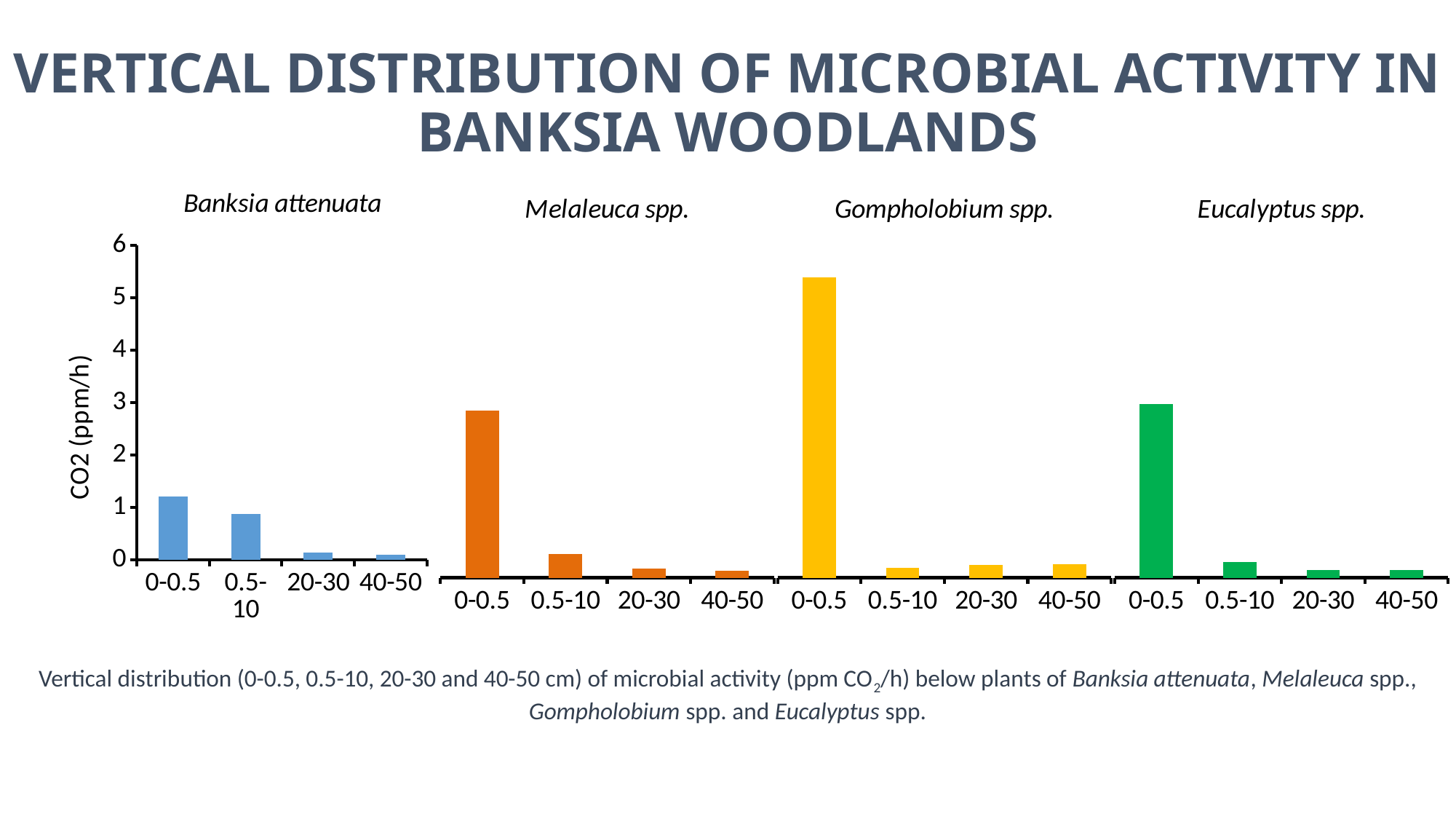
How many charts are shown on the slide? 4 In the Gompholobium spp. chart, which depth category has the highest value? 0-0.5 In the Banksia attenuata chart, which is larger, the value for 0-0.5 or for 0.5-10? 0-0.5 In the Gompholobium spp. chart, is the value for 0-0.5 greater or less than 4? greater In the Banksia attenuata chart, is the value for 0-0.5 greater or less than 1? greater Which is larger, the 0-0.5 value in the Gompholobium spp. chart or the 0-0.5 value in the Melaleuca spp. chart? Gompholobium spp. What is the label on the vertical axis of the Banksia attenuata chart? CO2 (ppm/h) What kind of chart is used for the Banksia attenuata panel? bar chart In the Banksia attenuata chart, do the values rise or fall from 0-0.5 to 40-50 along the x axis? fall In the Banksia attenuata chart, is the value for 0.5-10 greater or less than 1? less In the Banksia attenuata chart, how many depth categories are plotted? 4 In the Banksia attenuata chart, which depth category has the highest value? 0-0.5